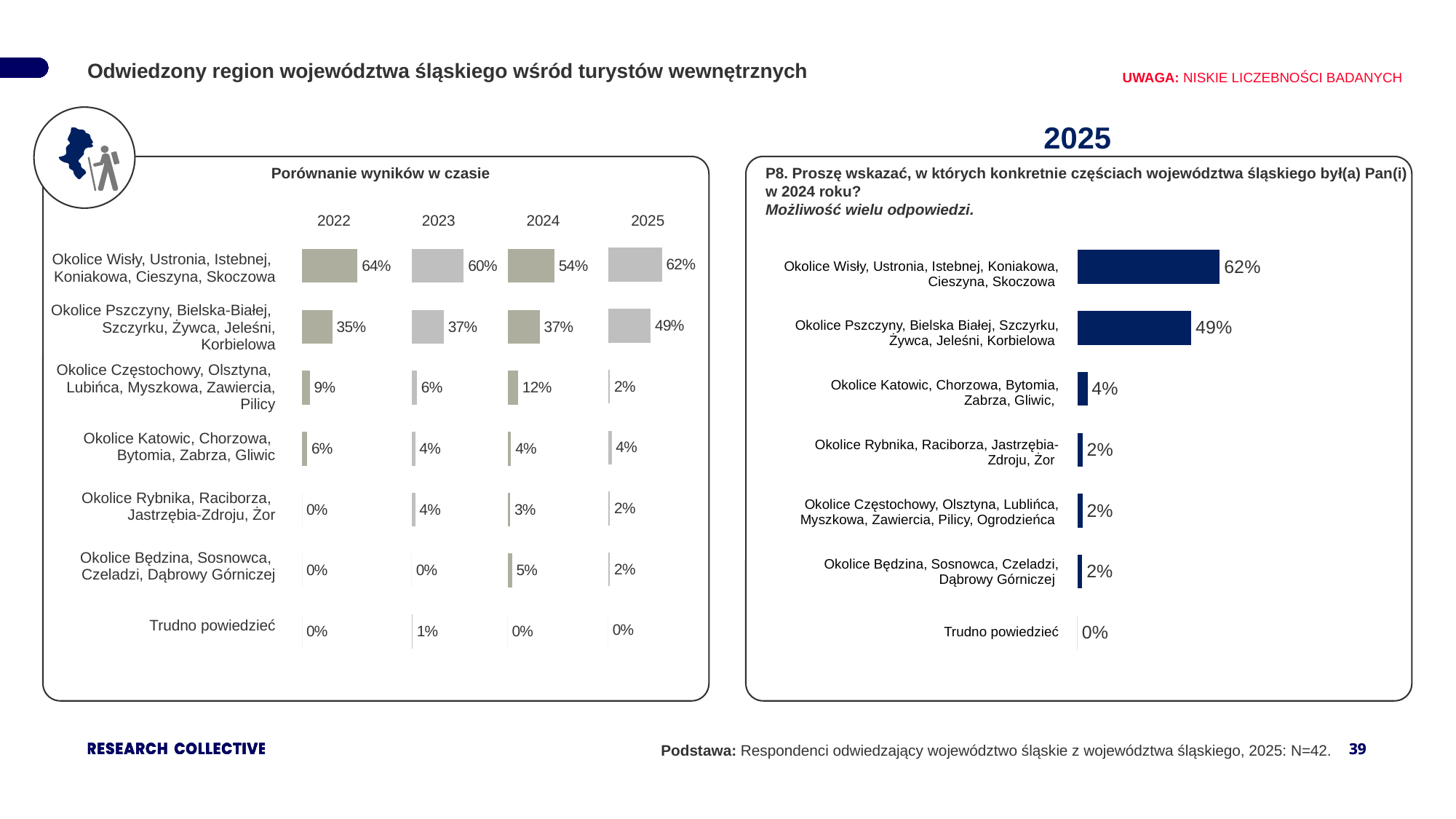
In the chart 'Porównanie wyników w czasie', how does the value for Okolice Pszczyny, Bielska-Białej, Szczyrku, Żywca, Jeleśni, Korbielowa change from 2024 to 2025? It rises from 37% to 49% How many years are compared in the chart 'Porównanie wyników w czasie'? 4 In the right-hand chart (2025), which category has the highest value? Okolice Wisły, Ustronia, Istebnej, Koniakowa, Cieszyna, Skoczowa In the right-hand chart (2025), what is the value for Okolice Katowic, Chorzowa, Bytomia, Zabrza, Gliwic? 4% In the right-hand chart (2025), which category has the lowest value? Trudno powiedzieć In the chart 'Porównanie wyników w czasie', which is larger for Okolice Pszczyny, Bielska-Białej, Szczyrku, Żywca, Jeleśni, Korbielowa: the 2022 value or the 2025 value? 2025 value What kind of chart is the right-hand chart (2025)? Bar chart In the chart 'Porównanie wyników w czasie', what is the 2024 value for Okolice Częstochowy, Olsztyna, Lubińca, Myszkowa, Zawiercia, Pilicy? 12% In the right-hand chart (2025), what is the difference between the values for Okolice Wisły, Ustronia, Istebnej, Koniakowa, Cieszyna, Skoczowa and Okolice Pszczyny, Bielska Białej, Szczyrku, Żywca, Jeleśni, Korbielowa? 13 percentage points In the right-hand chart (2025), what is the value for Okolice Wisły, Ustronia, Istebnej, Koniakowa, Cieszyna, Skoczowa? 62% In the chart 'Porównanie wyników w czasie', what is the 2022 value for Okolice Wisły, Ustronia, Istebnej, Koniakowa, Cieszyna, Skoczowa? 64% How many categories are shown in the right-hand chart (2025)? 7